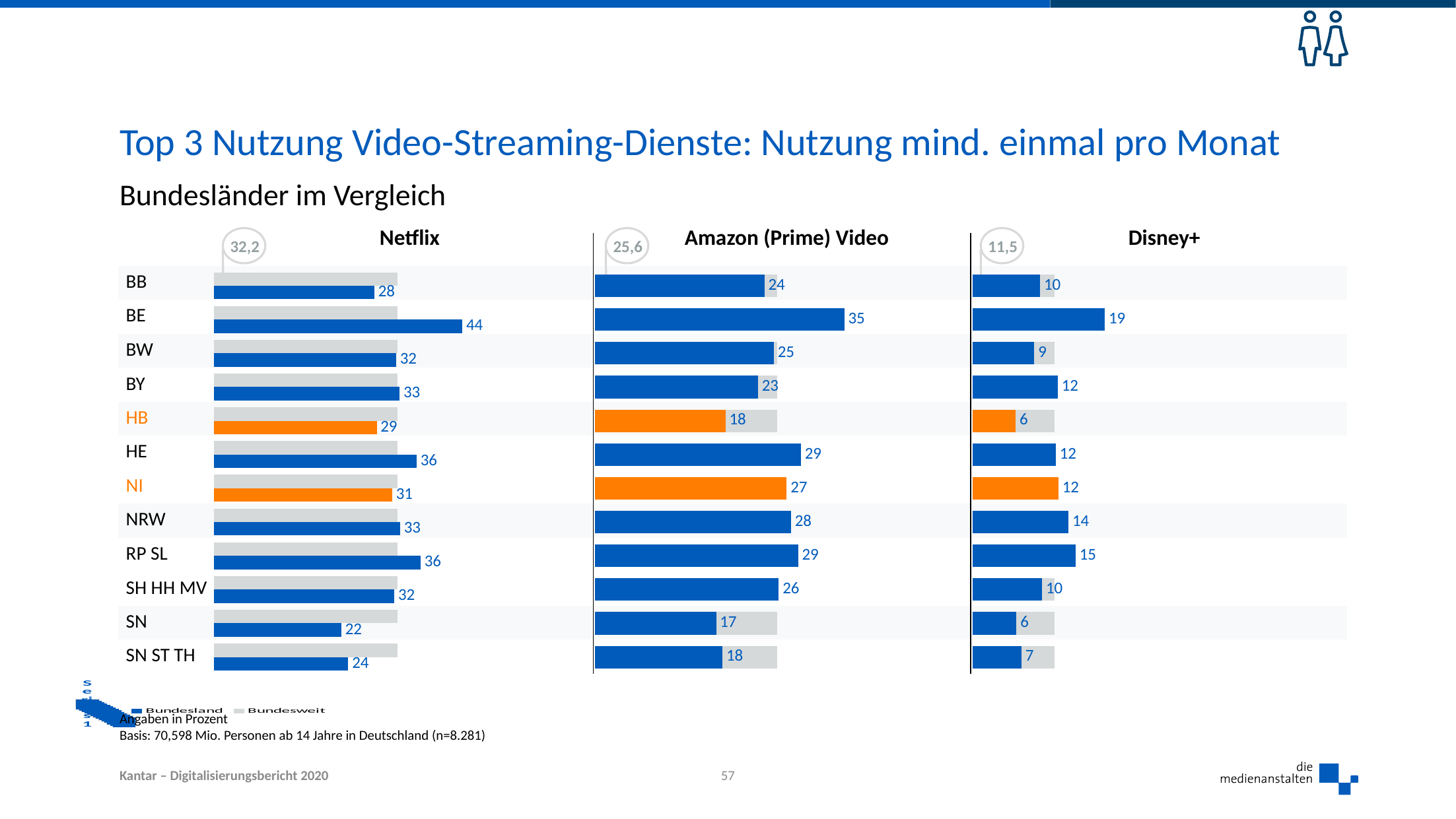
In the Amazon (Prime) Video chart, what is the value for HB? 18 In the Amazon (Prime) Video chart, which Bundesland has the lowest value? SN In the Disney+ chart, what is the value for NRW? 14 In the Disney+ chart, which Bundesland has the highest value? BE In the Amazon (Prime) Video chart, which is larger, the value for BE or the value for HE? BE In the Netflix chart, which Bundesland has the lowest value? SN What is the nationwide (Bundesweit) value shown for Amazon (Prime) Video? 25,6 In the Netflix chart, what is the value for BE? 44 In the Netflix chart, what is the difference between the values for BE and SN? 22 In the Netflix chart, which Bundesland has the highest value? BE How many Bundesländer (categories) are shown in the Disney+ chart? 12 What type of chart is used for the Netflix data? Bar chart